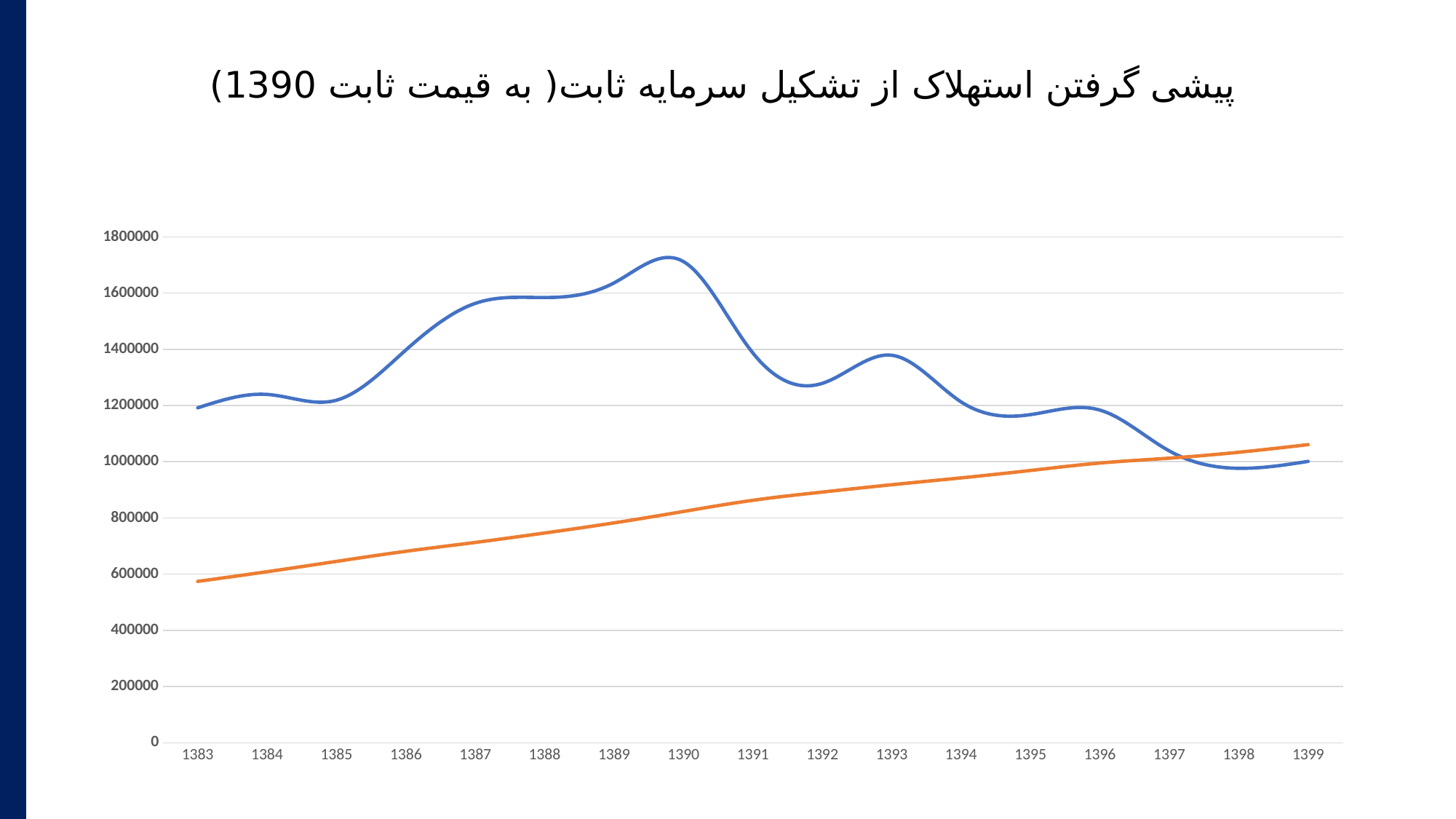
Is the value of the orange line in 1399 greater or less than 1000000? greater In which year does the blue line reach its highest value? 1390 In 1399, which line has the higher value, the blue line or the orange line? the orange line Is the value of the orange line in 1383 greater or less than 600000? less How many years are shown along the x axis of the chart? 17 In 1383, which line has the higher value, the blue line or the orange line? the blue line Is the value of the blue line in 1390 greater or less than 1600000? greater In which year does the blue line reach its lowest value? 1398 Does the orange line rise or fall from 1383 to 1399? rise How many lines are plotted on the chart? 2 In which year does the orange line reach its lowest value? 1383 What kind of chart is shown on the slide? line chart